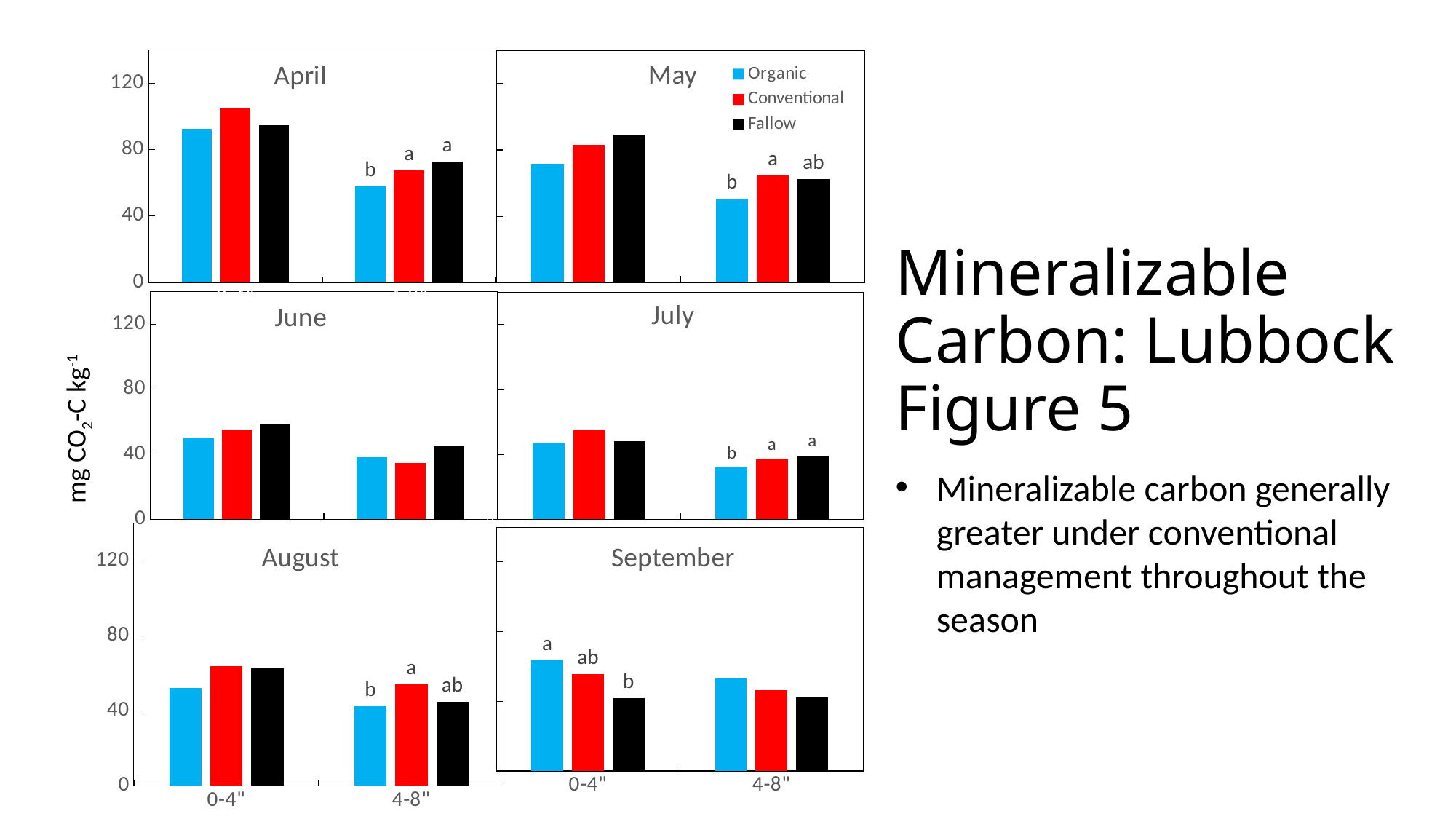
In the August panel at 4-8", which is larger, Conventional or Organic? Conventional In the April panel, is the value for Conventional at 0-4" greater or less than 80? greater How many depth categories are shown on the x axis of the August panel? 2 In the May panel, is the value for Organic at 4-8" greater or less than 80? less In the September panel, which series has the lowest value at 0-4"? Fallow In the April panel, which series has the highest value at 0-4"? Conventional In the September panel at 0-4", which is larger, Organic or Conventional? Organic What kind of chart is used in each monthly panel of the Mineralizable Carbon: Lubbock figure? bar chart How many series does the legend list in the May panel? 3 How many monthly panels are shown in the figure? 6 In the July panel, is the value for Organic at 4-8" greater or less than 40? less What are the three series named in the legend? Organic, Conventional, Fallow